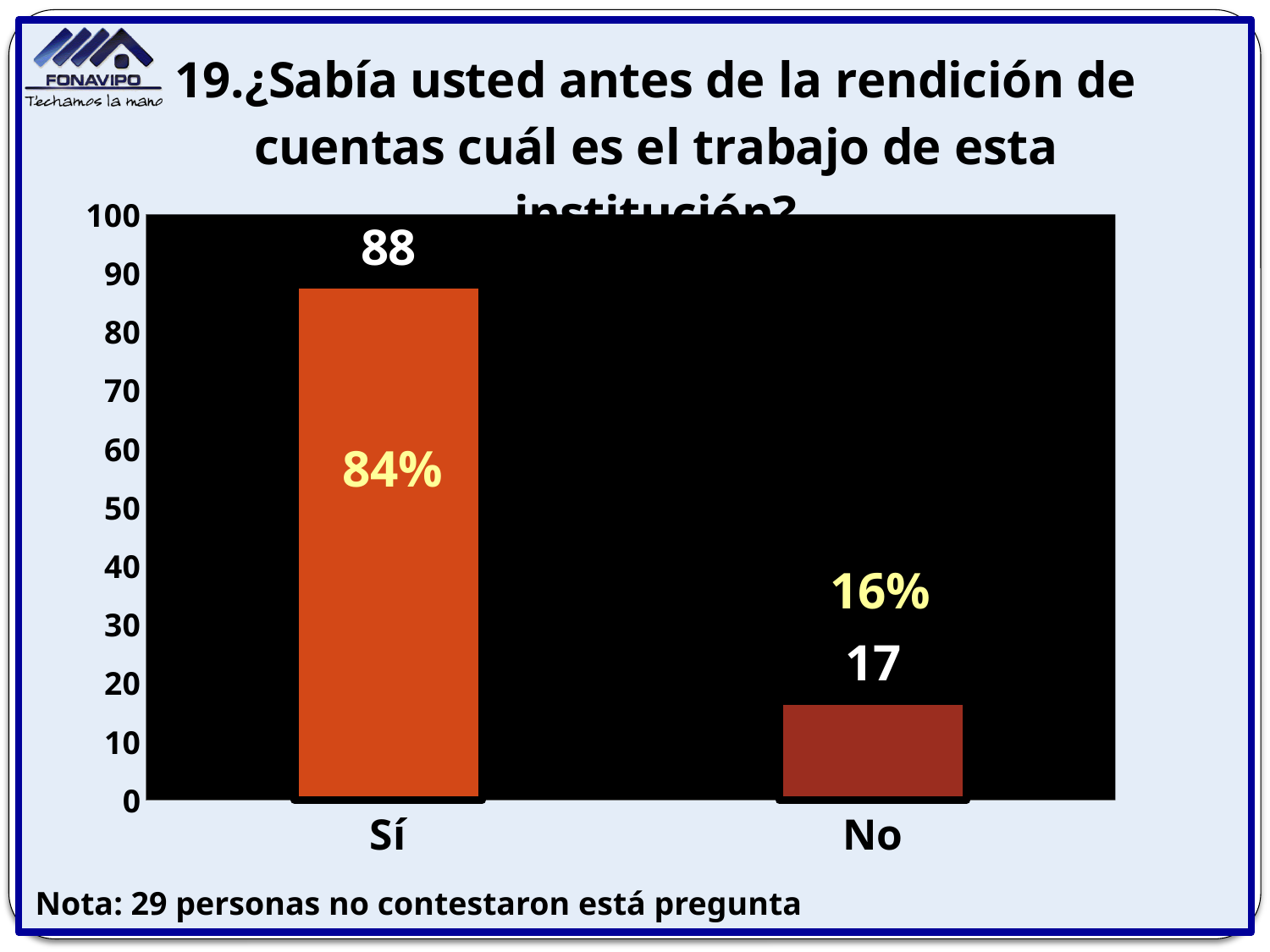
What kind of chart is shown on the slide? bar chart According to the note at the bottom of the slide, how many people did not answer this question? 29 What is the value for No? 17 Which is larger, the value for Sí or the value for No? Sí Which category has the lowest value? No Which category has the highest value? Sí What percentage is shown on the Sí bar? 84% Is the value for No greater or less than 20? less What is the difference between the values for Sí and No? 71 What is the value for Sí? 88 How many categories are shown on the x axis? 2 What percentage is shown for No? 16%